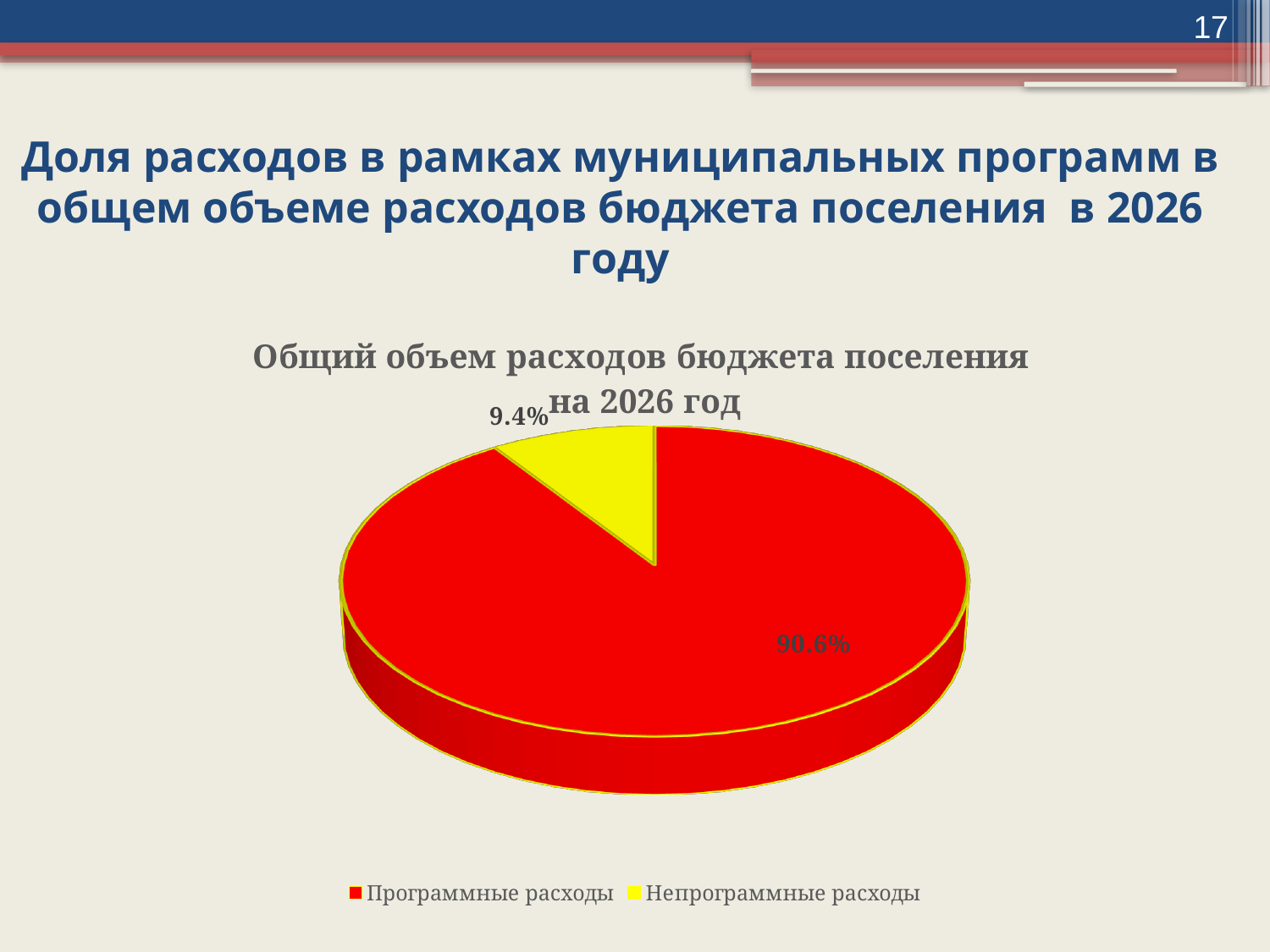
What is the share for Программные расходы? 90.6% Which is larger: the share for Программные расходы or for Непрограммные расходы? Программные расходы How many entries does the legend list? 2 How many slices does the pie chart have? 2 What is the share for Непрограммные расходы? 9.4% What is the difference in percentage points between Программные расходы and Непрограммные расходы? 81.2 Which category has the smallest share of the pie? Непрограммные расходы What colour is the slice for Непрограммные расходы? yellow What is the total of the two slices shown? 100% Which category has the largest share of the pie? Программные расходы What is the title of the chart? Общий объем расходов бюджета поселения на 2026 год What kind of chart is shown on the slide? pie chart